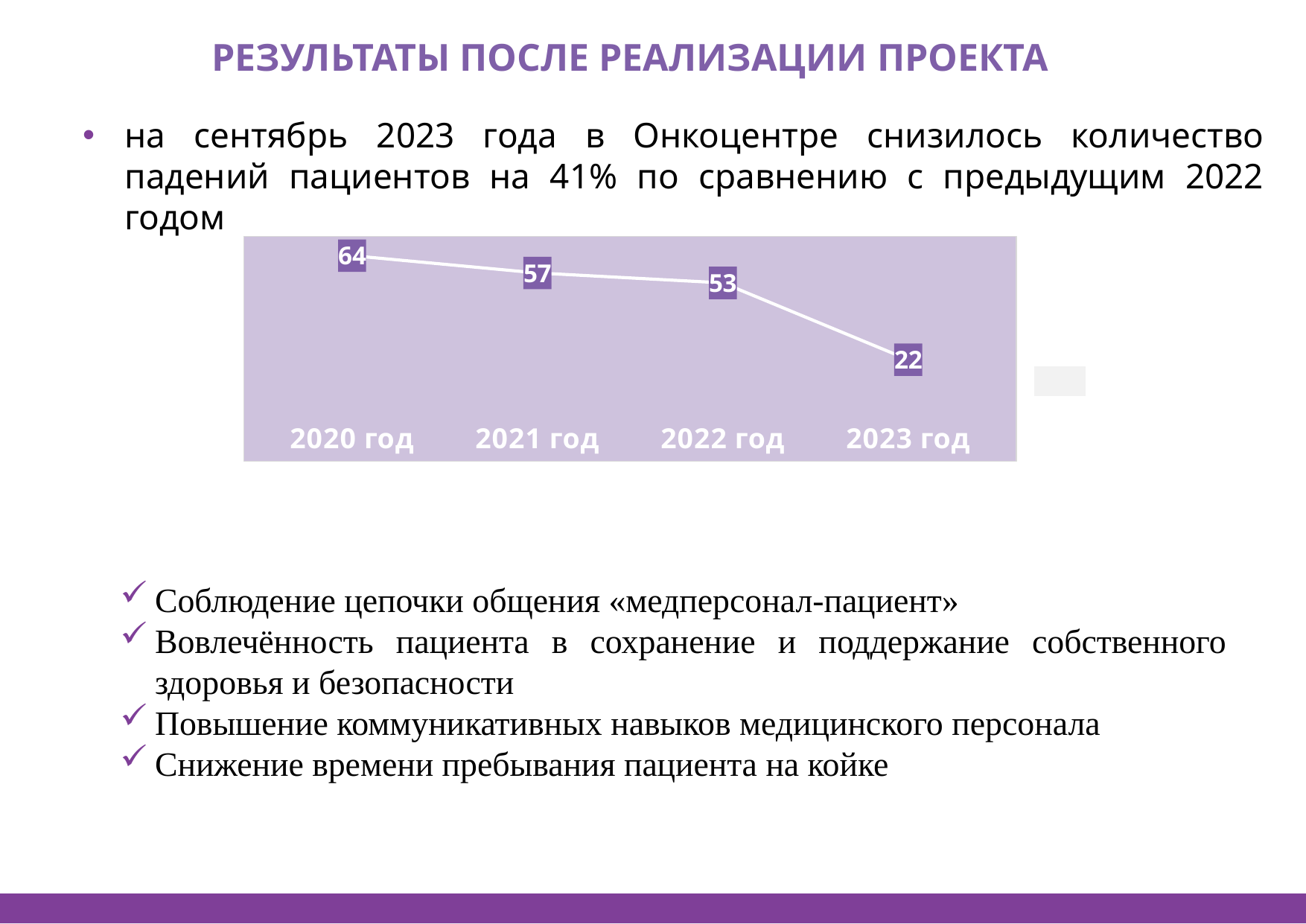
What is the difference between the values for 2020 год and 2021 год? 7 What kind of chart is shown on the slide? line chart What is the value for 2023 год? 22 What is the value for 2020 год? 64 Which year has the highest value? 2020 год What is the value for 2022 год? 53 What is the value for 2021 год? 57 Which is larger, the value for 2021 год or the value for 2022 год? 2021 год Do the values rise or fall from 2020 год to 2023 год? fall Which year has the lowest value? 2023 год How many years are plotted on the chart? 4 What is the difference between the values for 2022 год and 2023 год? 31